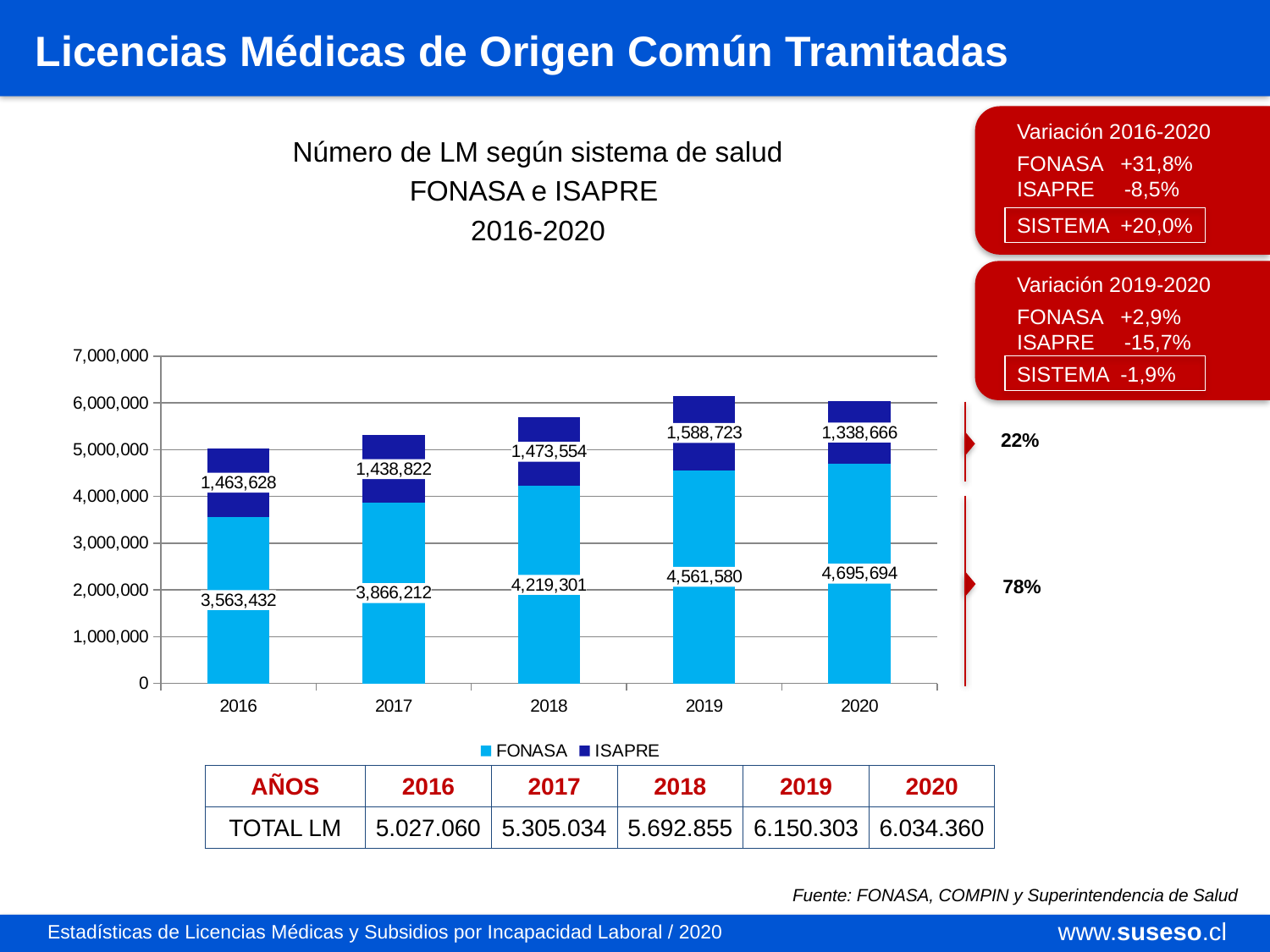
In which year is the ISAPRE value highest? 2019 Is the total height of the stacked bar for 2019 greater or less than 6,000,000? greater What is the total of the stacked bar for 2016 (FONASA plus ISAPRE)? 5,027,060 What is the FONASA value for 2018? 4,219,301 In which year is the FONASA value lowest? 2016 What is the ISAPRE value for 2020? 1,338,666 Which is larger, the ISAPRE value for 2017 or for 2018? 2018 Do the FONASA values rise or fall from 2016 to 2020? Rise How many series does the chart legend list? 2 How many years are shown on the x axis of the chart? 5 What kind of chart is shown on the slide? Stacked bar chart What is the difference between the FONASA values for 2020 and 2016? 1,132,262